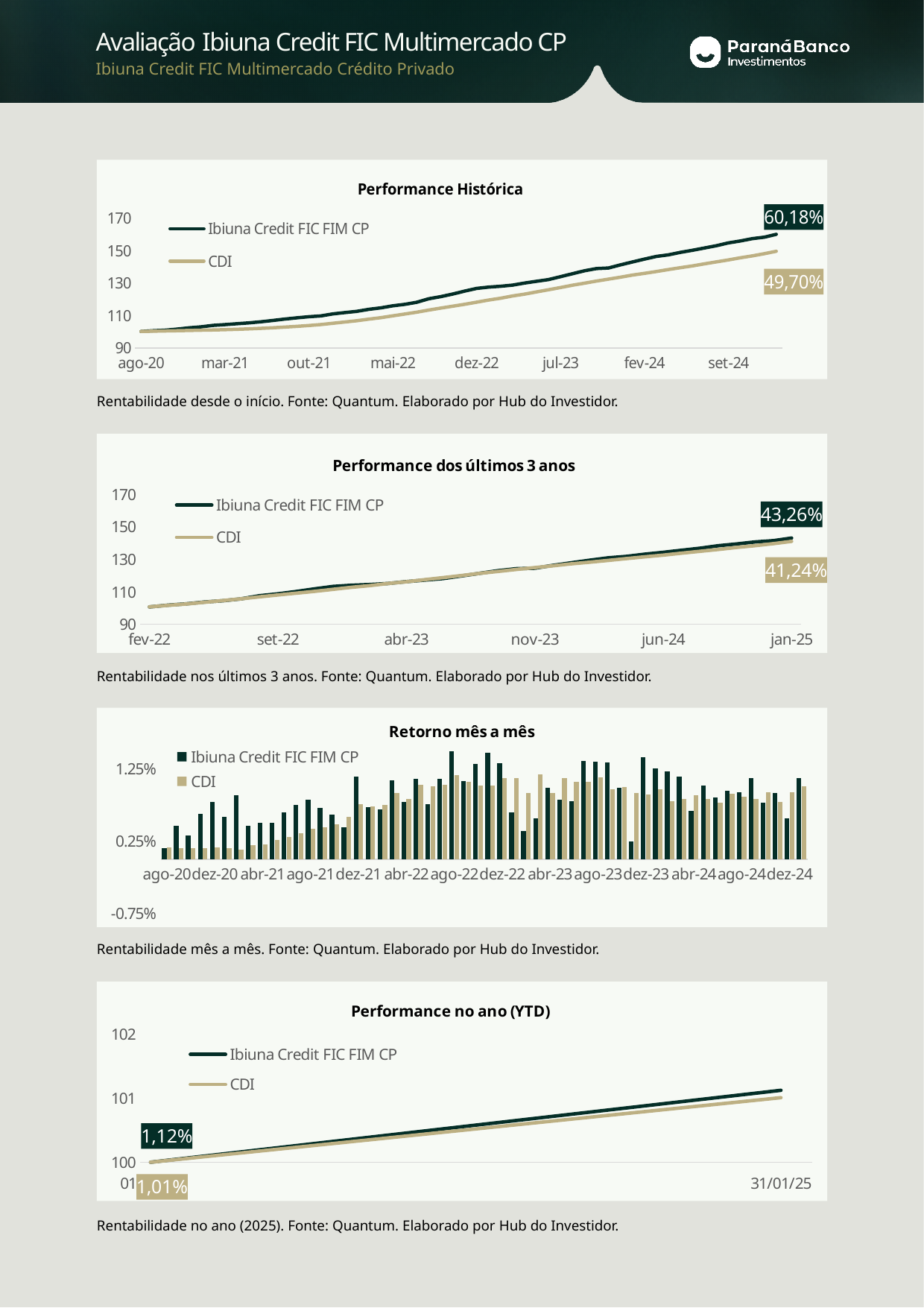
In the 'Performance Histórica' chart, what is the labelled final value for Ibiuna Credit FIC FIM CP? 60,18% How many series does the legend of the 'Retorno mês a mês' chart list? 2 In the 'Performance no ano (YTD)' chart, what is the difference between the labelled values for Ibiuna Credit FIC FIM CP (1,12%) and CDI (1,01%)? 0,11 percentage points In the 'Performance Histórica' chart, do the lines rise or fall from ago-20 to set-24? rise In the 'Performance Histórica' chart, what is the difference between the labelled values for Ibiuna Credit FIC FIM CP and CDI? 10,48 percentage points In the 'Performance dos últimos 3 anos' chart, what is the labelled value for Ibiuna Credit FIC FIM CP? 43,26% In the 'Performance dos últimos 3 anos' chart, what is the labelled value for CDI? 41,24% In the 'Performance Histórica' chart, is the final value of the Ibiuna Credit FIC FIM CP line greater or less than 150? greater In the 'Performance dos últimos 3 anos' chart, which series has the higher labelled value, Ibiuna Credit FIC FIM CP or CDI? Ibiuna Credit FIC FIM CP In the 'Performance dos últimos 3 anos' chart, is the final value of the Ibiuna Credit FIC FIM CP line greater or less than 130? greater In the 'Performance Histórica' chart, what is the labelled final value for CDI? 49,70% What kind of chart is 'Retorno mês a mês'? bar chart